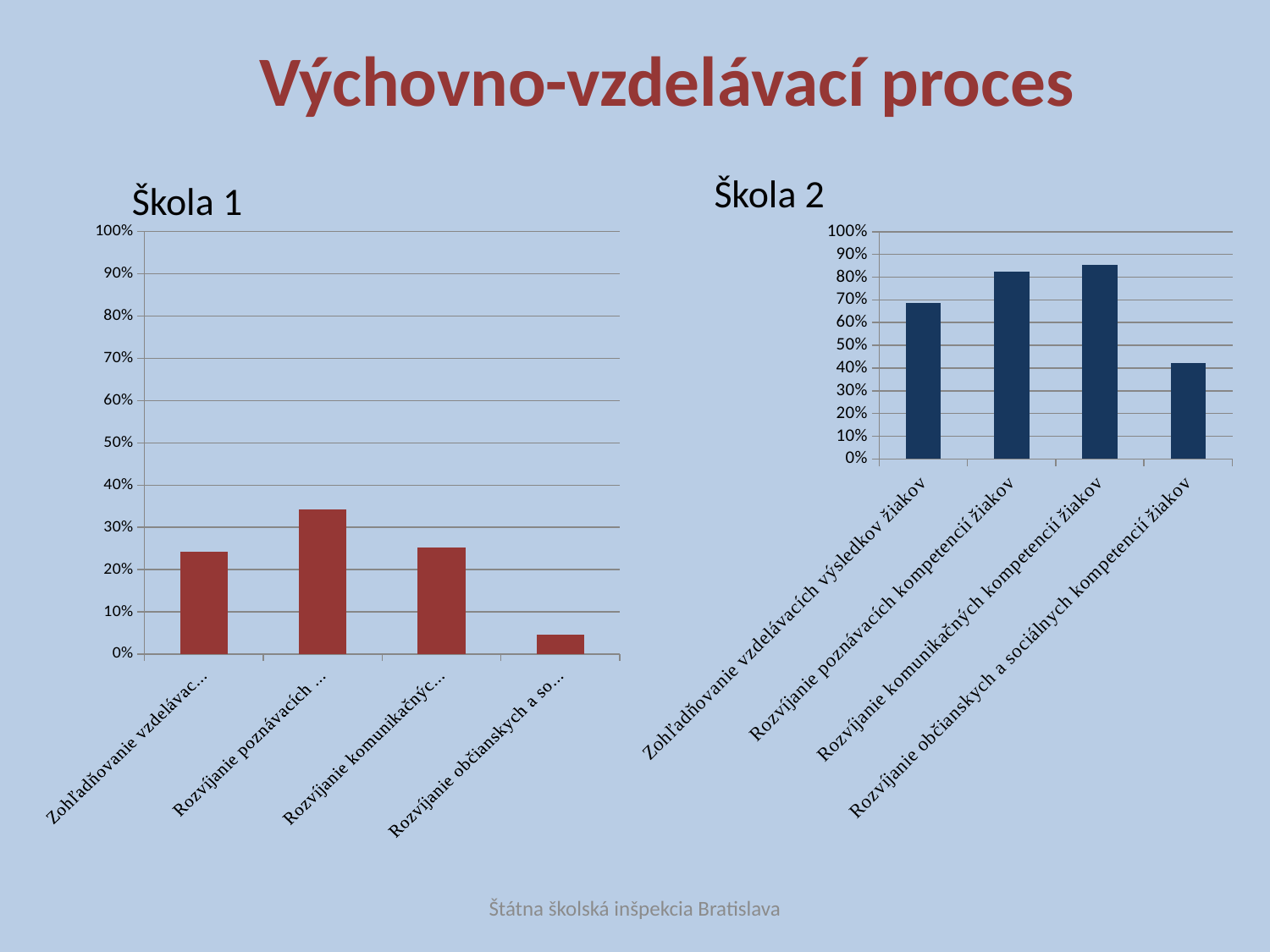
In the Škola 1 chart, which is larger: the first bar (Zohľadňovanie vzdelávac...) or the second bar (Rozvíjanie poznávacích ...)? Rozvíjanie poznávacích ... In the Škola 2 chart, which is larger: the value for Rozvíjanie komunikačných kompetencií žiakov or the value for Rozvíjanie občianskych a sociálnych kompetencií žiakov? Rozvíjanie komunikačných kompetencií žiakov In the Škola 1 chart, which category has the highest bar? Rozvíjanie poznávacích ... In the Škola 2 chart, is the value for Zohľadňovanie vzdelávacích výsledkov žiakov greater or less than 60%? greater In the Škola 1 chart, is the value for Rozvíjanie občianskych a so... greater or less than 10%? less What is the title of the slide containing the two charts? Výchovno-vzdelávací proces In the Škola 2 chart, which category has the lowest value? Rozvíjanie občianskych a sociálnych kompetencií žiakov In the Škola 1 chart, is the value for Rozvíjanie poznávacích ... greater or less than 30%? greater How many bars does the Škola 2 chart show? 4 In the Škola 1 chart, which category has the lowest bar? Rozvíjanie občianskych a so... What kind of chart is the Škola 1 chart? bar chart